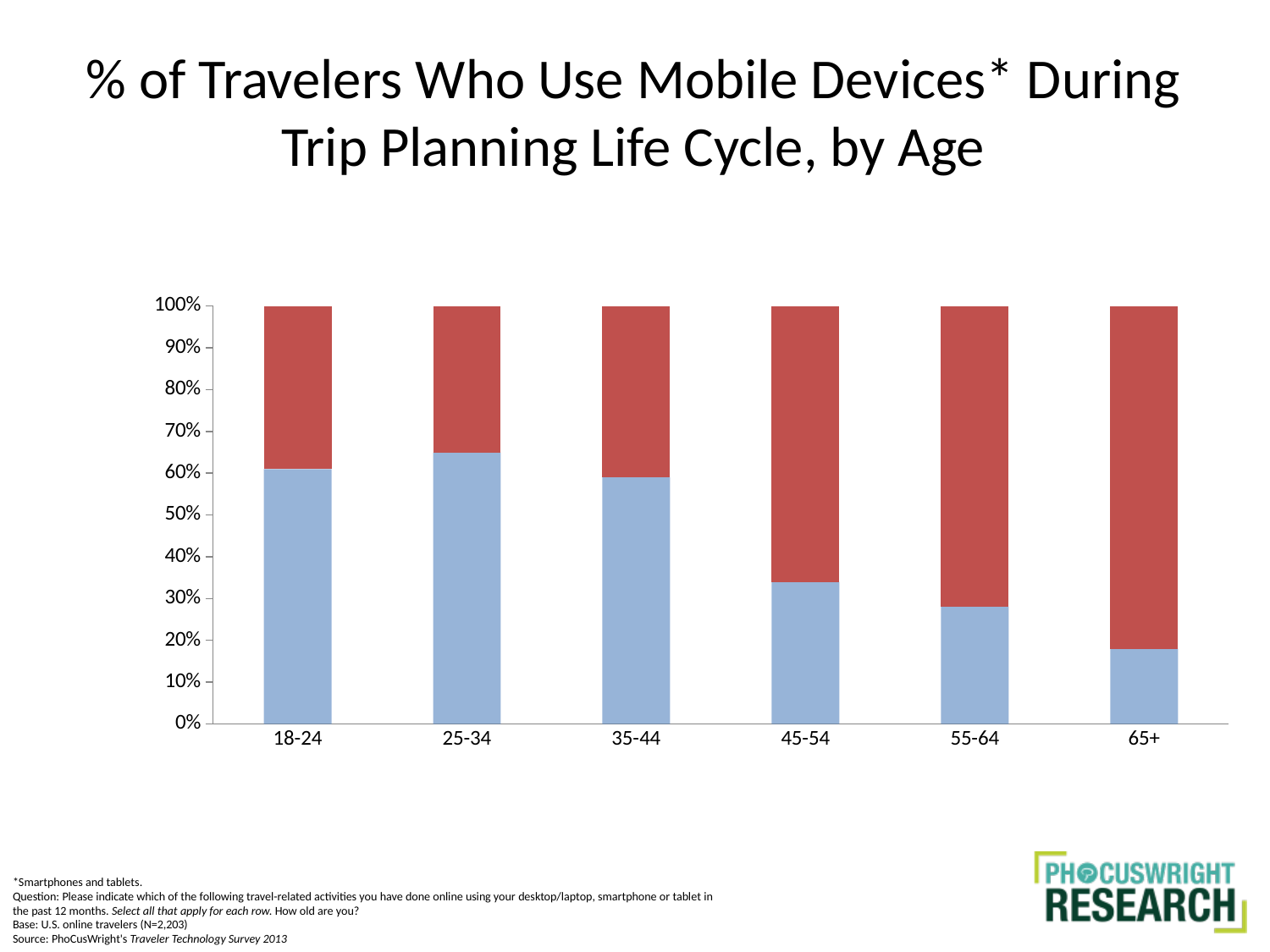
Which age group has the largest blue segment? 25-34 How many age groups are shown on the x axis of the chart? 6 Is the blue segment for the 45-54 age group greater or less than 40%? less Which age group has a larger blue segment, 18-24 or 45-54? 18-24 What kind of chart is shown on the slide? Stacked bar chart Is the blue segment for the 18-24 age group greater or less than 50%? greater Is the blue segment for the 65+ age group greater or less than 30%? less What is the total height of the stacked bar for the 18-24 age group? 100% From the 35-44 age group to the 65+ age group, does the blue segment rise or fall? fall Which age group has the smallest blue segment? 65+